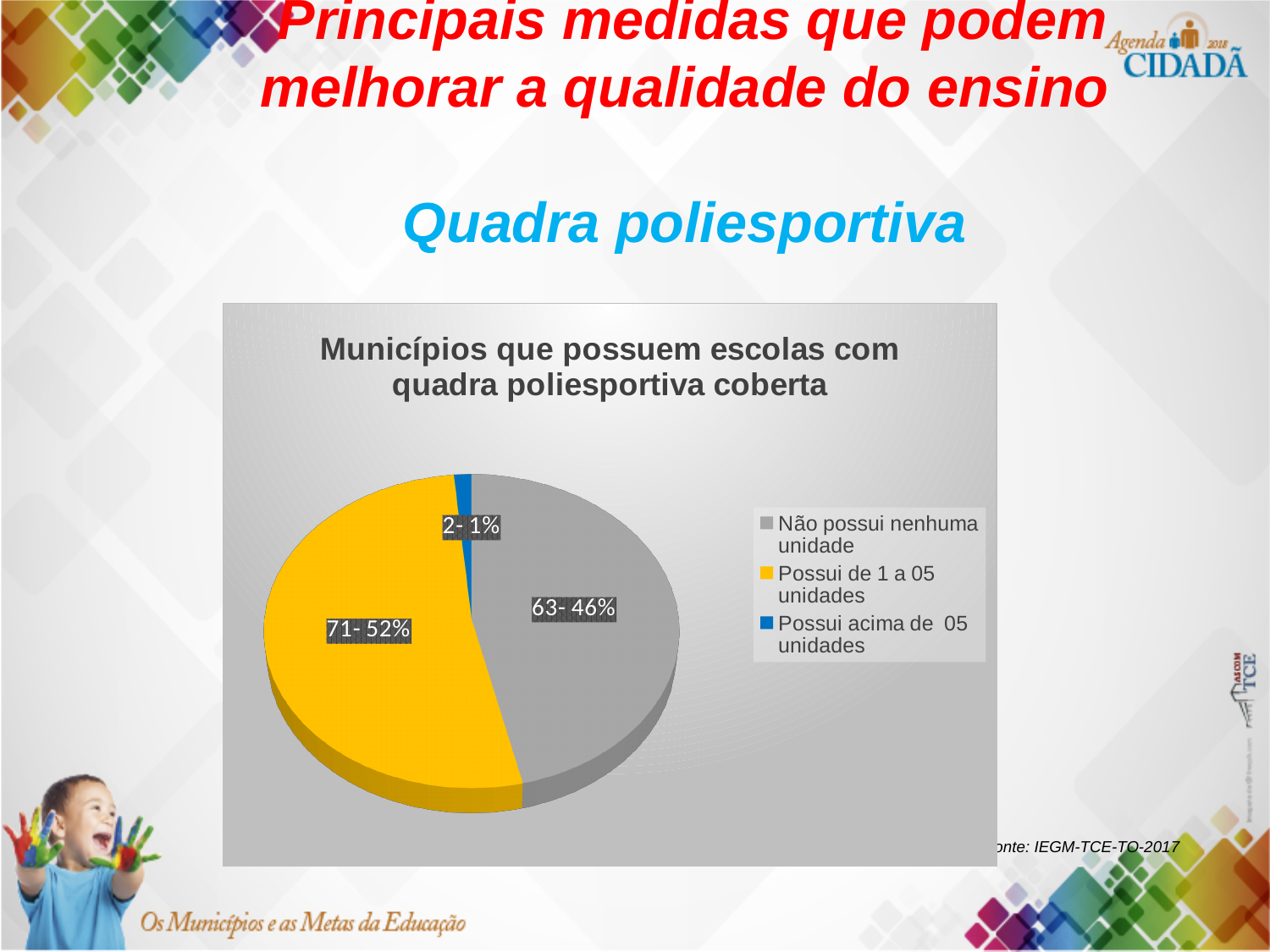
What percentage share is shown for 'Possui de 1 a 05 unidades'? 52% What type of chart is shown on the slide? pie chart How many municipalities are in the 'Possui de 1 a 05 unidades' slice? 71 Which category has the smallest slice? Possui acima de 05 unidades What is the title of the chart? Municípios que possuem escolas com quadra poliesportiva coberta How many slices does the pie chart have? 3 How many entries does the legend list? 3 How many municipalities are in the 'Não possui nenhuma unidade' slice? 63 Which category has the largest slice? Possui de 1 a 05 unidades What is the difference in the number of municipalities between 'Possui de 1 a 05 unidades' and 'Não possui nenhuma unidade'? 8 What percentage share is shown for 'Possui acima de 05 unidades'? 1% What percentage share is shown for 'Não possui nenhuma unidade'? 46%